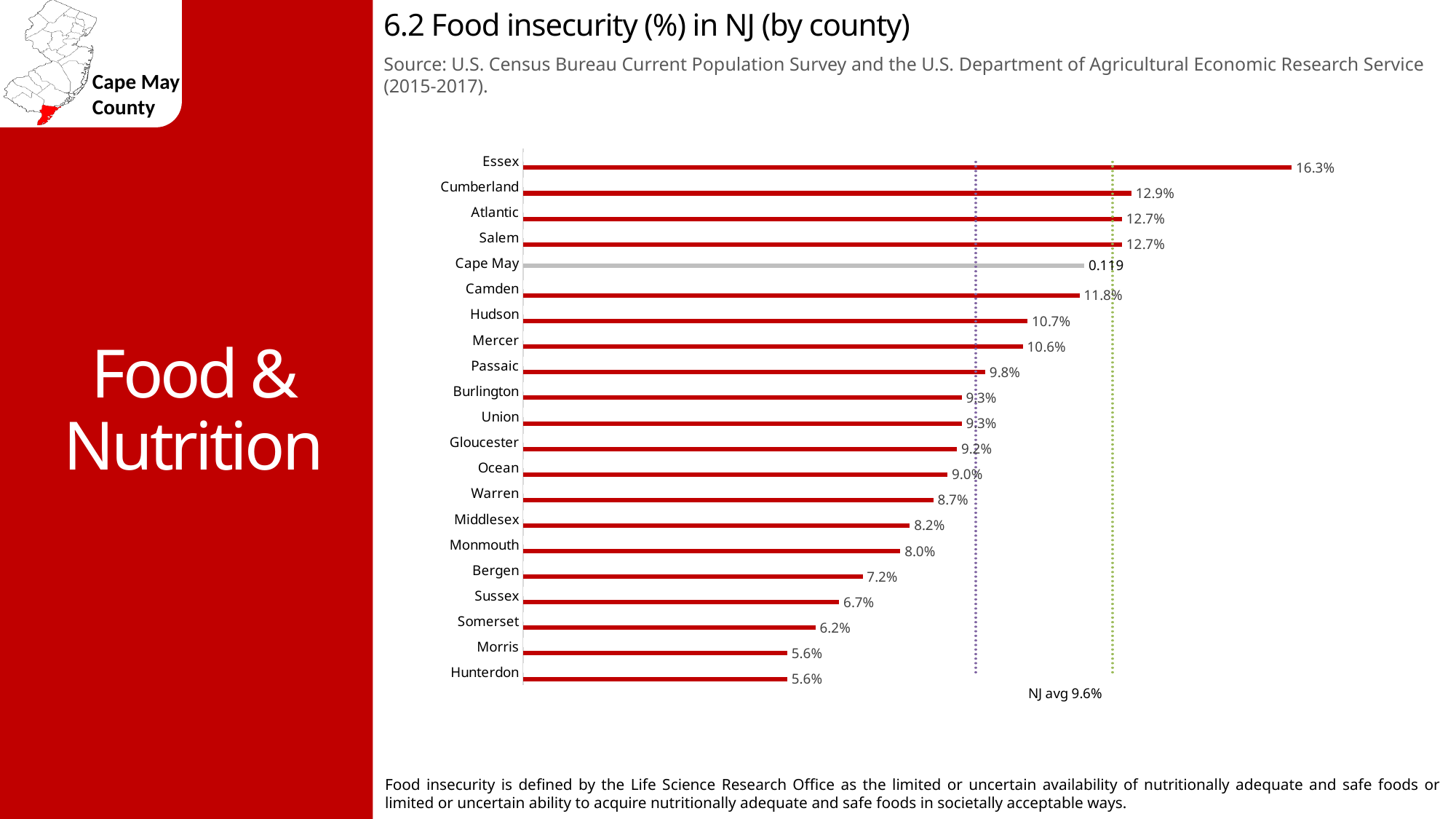
What is the food insecurity percentage for Essex county? 16.3% What kind of chart is used to show food insecurity by county? Bar chart What is the food insecurity percentage for Hudson county? 10.7% Do the values rise or fall going from the top bar (Essex) to the bottom bar (Hunterdon)? Fall What value is labelled on the Cape May bar? 0.119 How many counties are shown in the chart? 21 What NJ average food insecurity percentage is noted on the chart? 9.6% Which county has the highest food insecurity percentage? Essex What is the difference in food insecurity between Bergen and Sussex counties? 0.5 percentage points Which county has a higher food insecurity percentage, Camden or Hudson? Camden What is the difference in food insecurity between Essex and Cumberland counties? 3.4 percentage points What is the food insecurity percentage for Somerset county? 6.2%